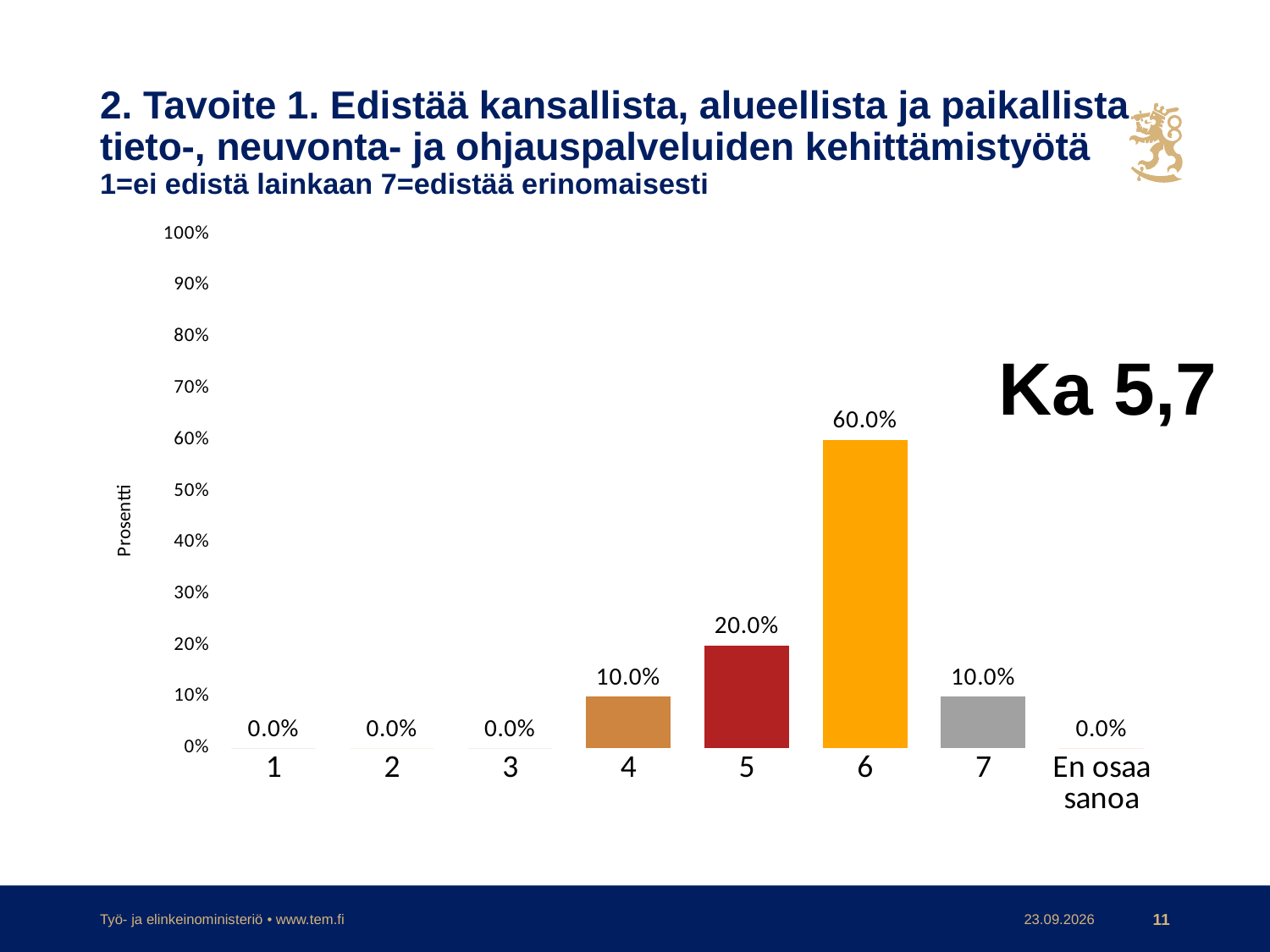
What is the value for category 5? 20.0% What kind of chart is shown on the slide? bar chart Which category has the highest value? 6 What is the value for category 6? 60.0% How many categories are shown on the x axis? 8 Which is larger, the value for category 5 or the value for category 7? 5 What mean value (Ka) is printed next to the chart? Ka 5,7 What is the difference between the values for category 6 and category 5? 40.0% What is the value for category 4? 10.0% What is the value for the 'En osaa sanoa' category? 0.0% Is the value for category 6 greater or less than 50%? greater What is the label of the y axis? Prosentti